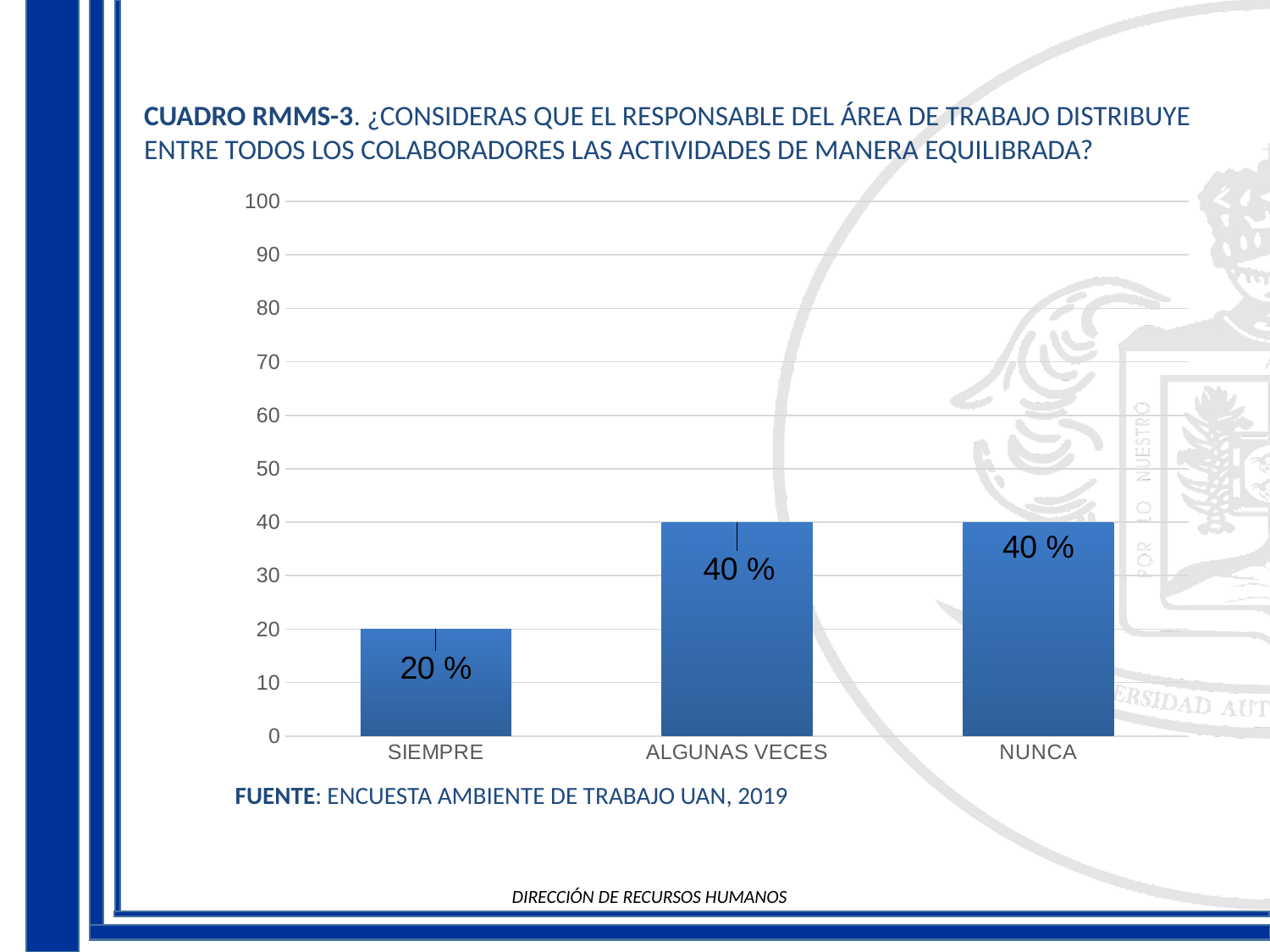
What is the value for SIEMPRE? 20 % Which category has the lowest value? SIEMPRE What is the value for NUNCA? 40 % What source is cited below the chart? ENCUESTA AMBIENTE DE TRABAJO UAN, 2019 What kind of chart is shown on the slide? bar chart Is the value for SIEMPRE greater or less than 30? less Is the value for ALGUNAS VECES greater or less than 30? greater What is the value for ALGUNAS VECES? 40 % What is the maximum value shown on the y axis? 100 What is the difference between the values for ALGUNAS VECES and SIEMPRE? 20 % Which is larger, the value for NUNCA or the value for SIEMPRE? NUNCA How many categories are shown on the x axis? 3